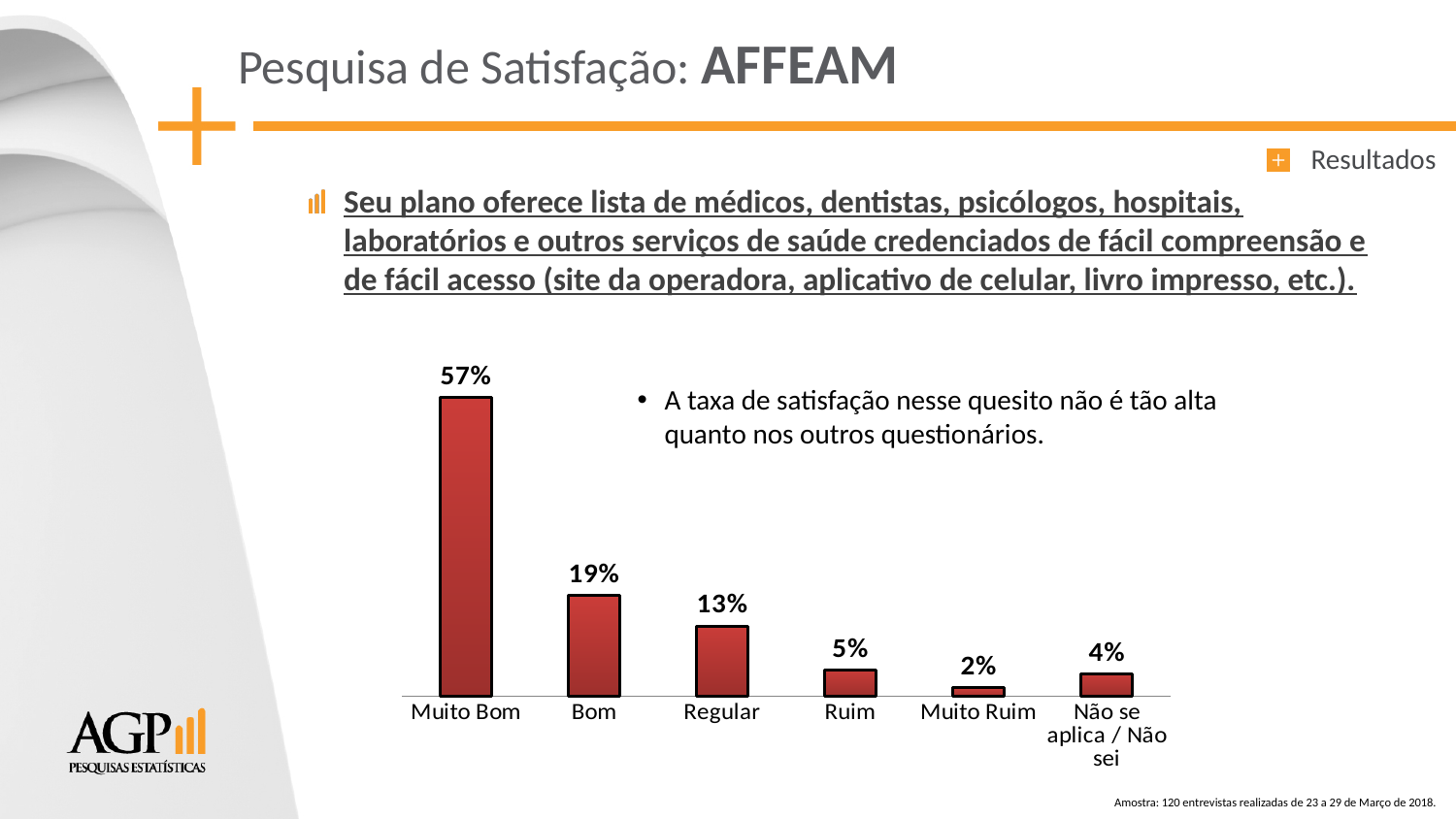
What percentage of respondents answered "Muito Bom"? 57% What colour are the bars in the chart? Red What is the value shown for "Regular"? 13% Which category has the lowest value? Muito Ruim What kind of chart is shown on the slide? Bar chart What is the difference between the values for "Ruim" and "Muito Ruim"? 3% What percentage is shown for "Não se aplica / Não sei"? 4% Which is larger, the value for "Ruim" or the value for "Não se aplica / Não sei"? Ruim How many categories are shown on the x axis of the chart? 6 What is the difference between the values for "Muito Bom" and "Bom"? 38% What is the value shown for the "Bom" category? 19% Which category has the highest value? Muito Bom